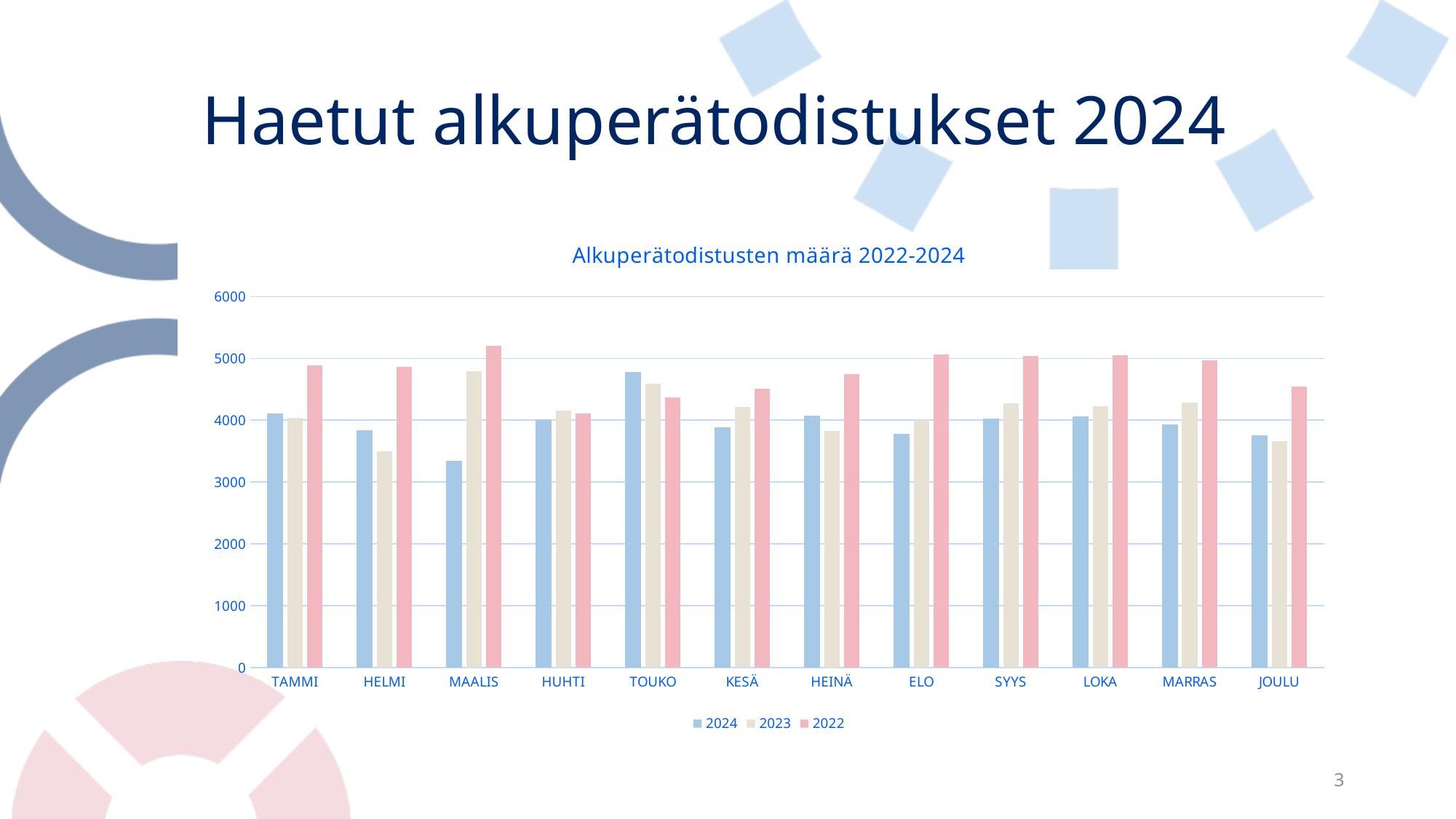
In which month is the 2024 value lowest? MAALIS For TOUKO, which series has the larger value, 2024 or 2022? 2024 What type of chart is shown on the slide? bar chart Is the 2024 value for MAALIS greater or less than 4000? less In which month is the 2024 value highest? TOUKO What is the title of the chart? Alkuperätodistusten määrä 2022-2024 In which month is the 2022 value highest? MAALIS Is the 2022 value for MAALIS greater or less than 5000? greater Which series does the pink colour represent in the legend? 2022 How many months (categories) are shown on the x axis? 12 In which month is the 2022 value lowest? HUHTI How many series does the legend list? 3